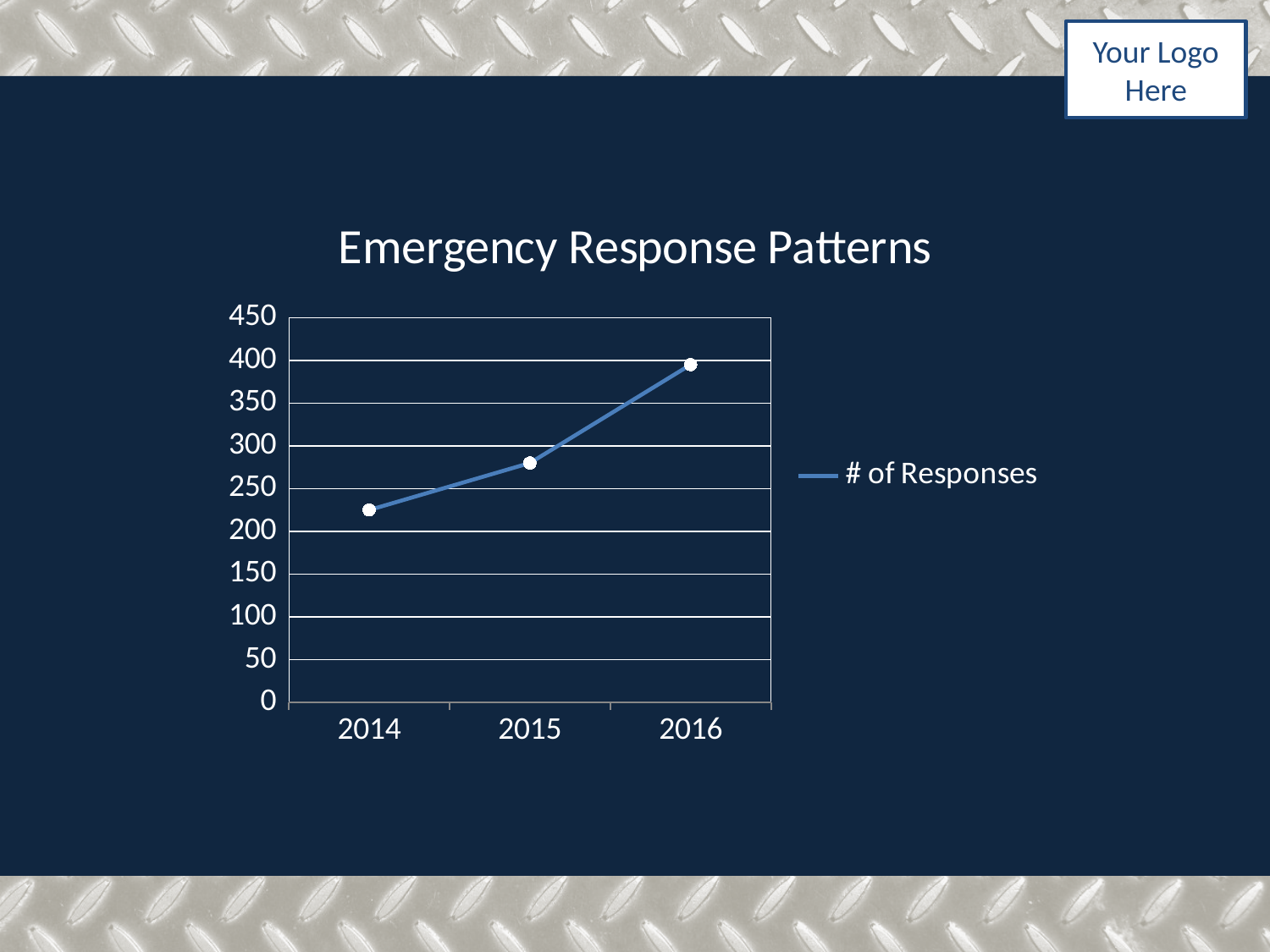
What kind of chart is shown on the slide? line chart Which year has more responses, 2015 or 2016? 2016 Is the value for 2015 greater or less than 300? less Which year has the lowest number of responses? 2014 Which year has the highest number of responses? 2016 How many years are plotted on the x axis? 3 What is the title of the chart? Emergency Response Patterns How many series does the legend list? 1 Do the values rise or fall from 2014 to 2016? rise Is the value for 2014 greater or less than 200? greater What is the name of the series shown in the legend? # of Responses Is the value for 2016 greater or less than 350? greater